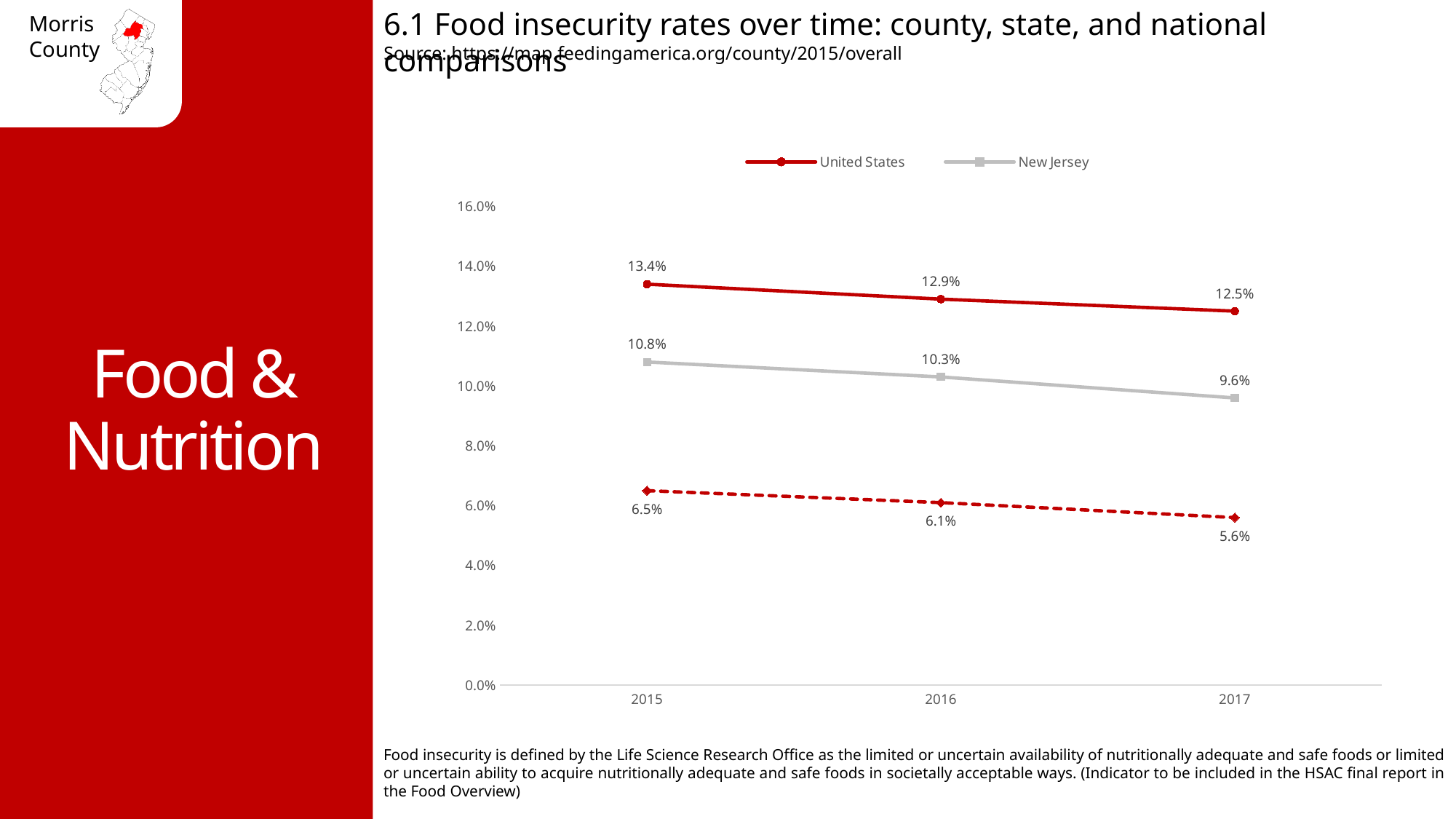
What kind of chart is shown on the slide? Line chart Which is larger in 2016, the United States rate or the New Jersey rate? United States Does the New Jersey line rise or fall from 2015 to 2017? Falls What is the food insecurity rate for New Jersey in 2017? 9.6% What is the food insecurity rate for the United States in 2015? 13.4% How many years are shown on the x axis? 3 How many series does the legend list? 2 What is the food insecurity rate for the United States in 2017? 12.5% What value does the dashed line show for 2016? 6.1% What is the difference between the United States and New Jersey rates in 2015? 2.6 percentage points In which year is the United States rate highest? 2015 By how much did the United States rate fall from 2015 to 2017? 0.9 percentage points